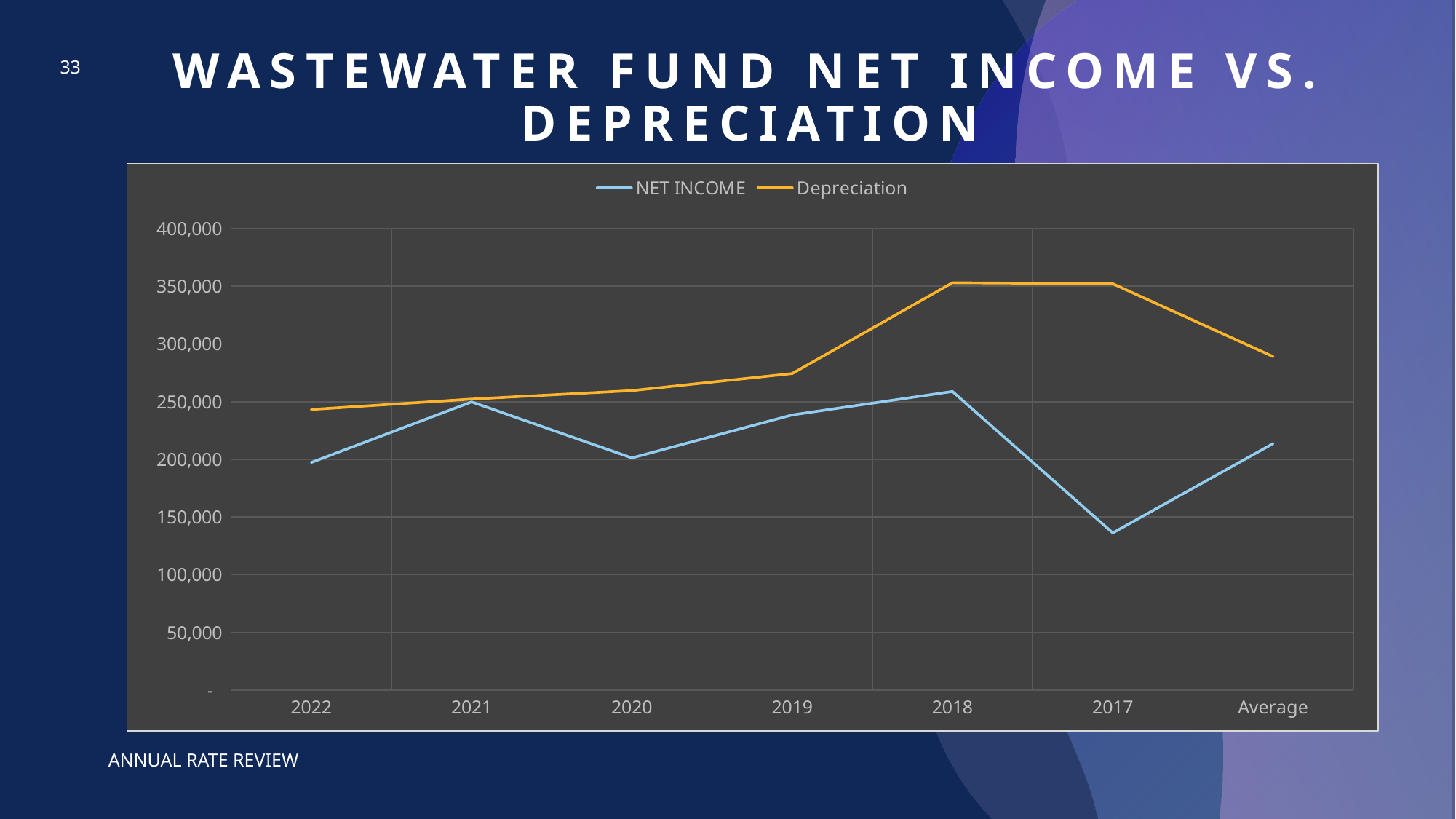
Is the NET INCOME value for 2021 greater or less than 200,000? greater In which year is NET INCOME lowest? 2017 For 2018, which series has the larger value, NET INCOME or Depreciation? Depreciation What kind of chart is shown on the slide? line chart In which category is Depreciation lowest? 2022 How many series does the legend list? 2 Which colour is used for the Depreciation line? orange How many categories are shown along the x axis? 7 Is the Depreciation value for 2019 greater or less than 250,000? greater Is the NET INCOME value for 2017 greater or less than 150,000? less Which is larger: NET INCOME in 2021 or NET INCOME in 2017? 2021